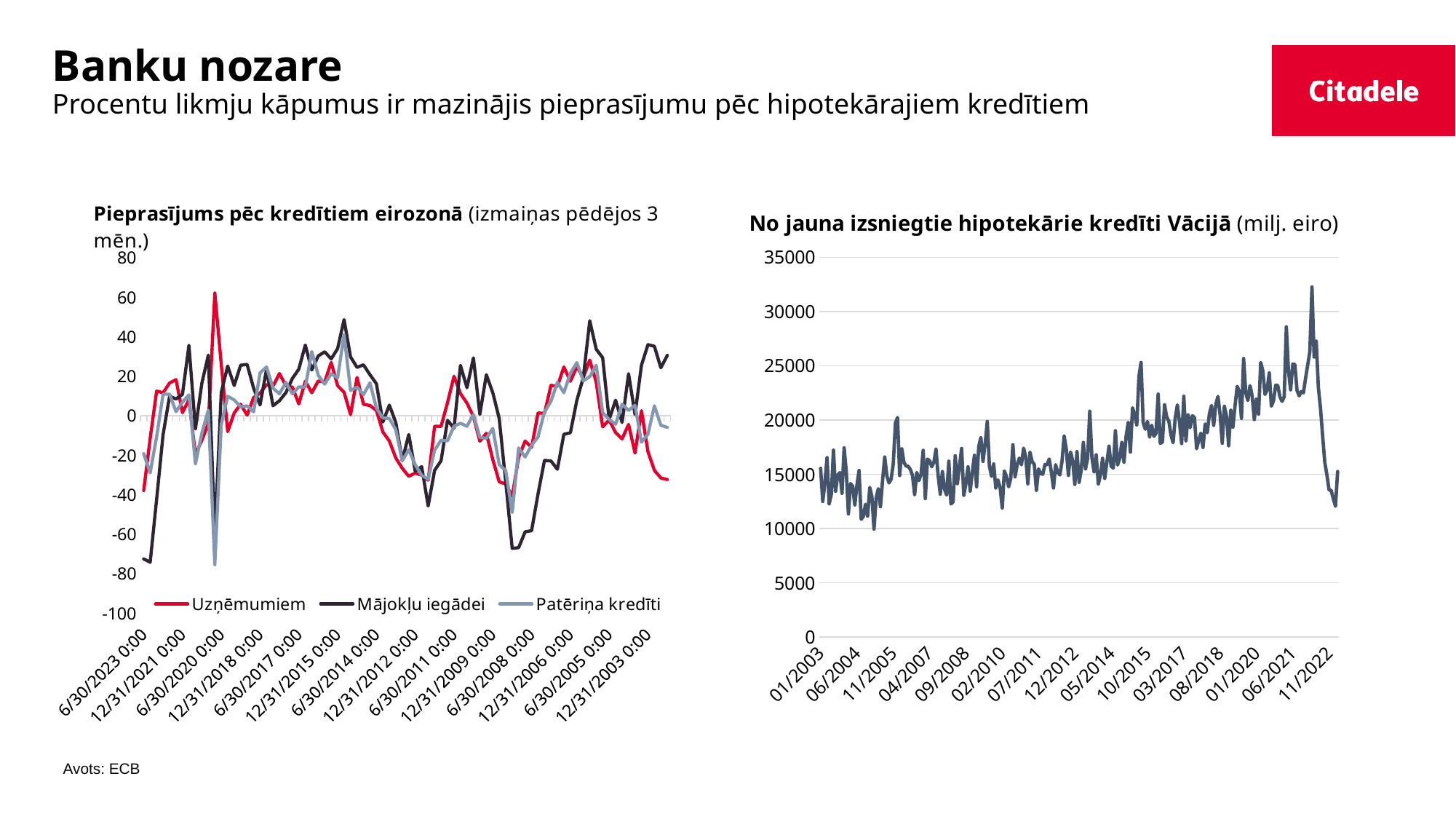
Which series are listed in the legend of the left chart? Uzņēmumiem, Mājokļu iegādei, Patēriņa kredīti In the left chart, is the value for Mājokļu iegādei at 6/30/2023 greater or less than -60? less In the left chart, which series is drawn in red? Uzņēmumiem What kind of chart is the left chart, 'Pieprasījums pēc kredītiem eirozonā'? line chart In the right chart, do the values generally rise or fall between 01/2003 and 06/2021? rise In the right chart, is the value at 11/2022 greater or less than 25000? less In the left chart, is the lowest value reached by Patēriņa kredīti greater or less than -60? less What kind of chart is the right chart, 'No jauna izsniegtie hipotekārie kredīti Vācijā'? line chart How many series does the legend of the left chart list? 3